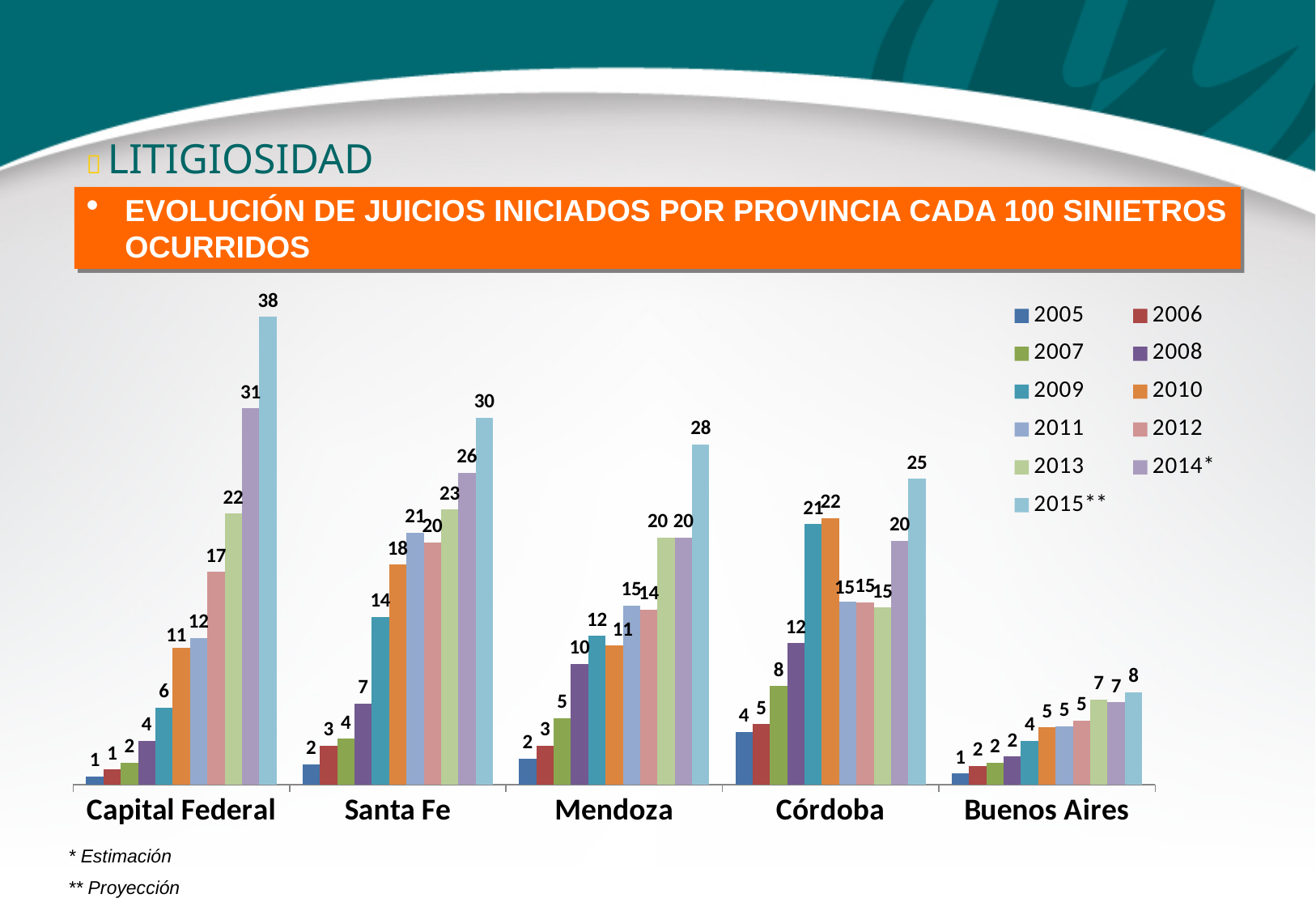
What is the value for Santa Fe in 2010? 18 Which province has the highest value in 2015**? Capital Federal How many series does the legend list? 11 Which province has the lowest value in 2015**? Buenos Aires What is the value for Capital Federal in 2015**? 38 Which is larger, the 2014* value for Córdoba or the 2014* value for Santa Fe? Santa Fe What is the difference between the 2015** values for Capital Federal and Santa Fe? 8 What kind of chart is shown on the slide? Bar chart What is the value for Córdoba in 2009? 21 How many provinces are shown on the x axis? 5 What is the value for Mendoza in 2013? 20 Which year in the legend is marked as a projection (Proyección)? 2015**